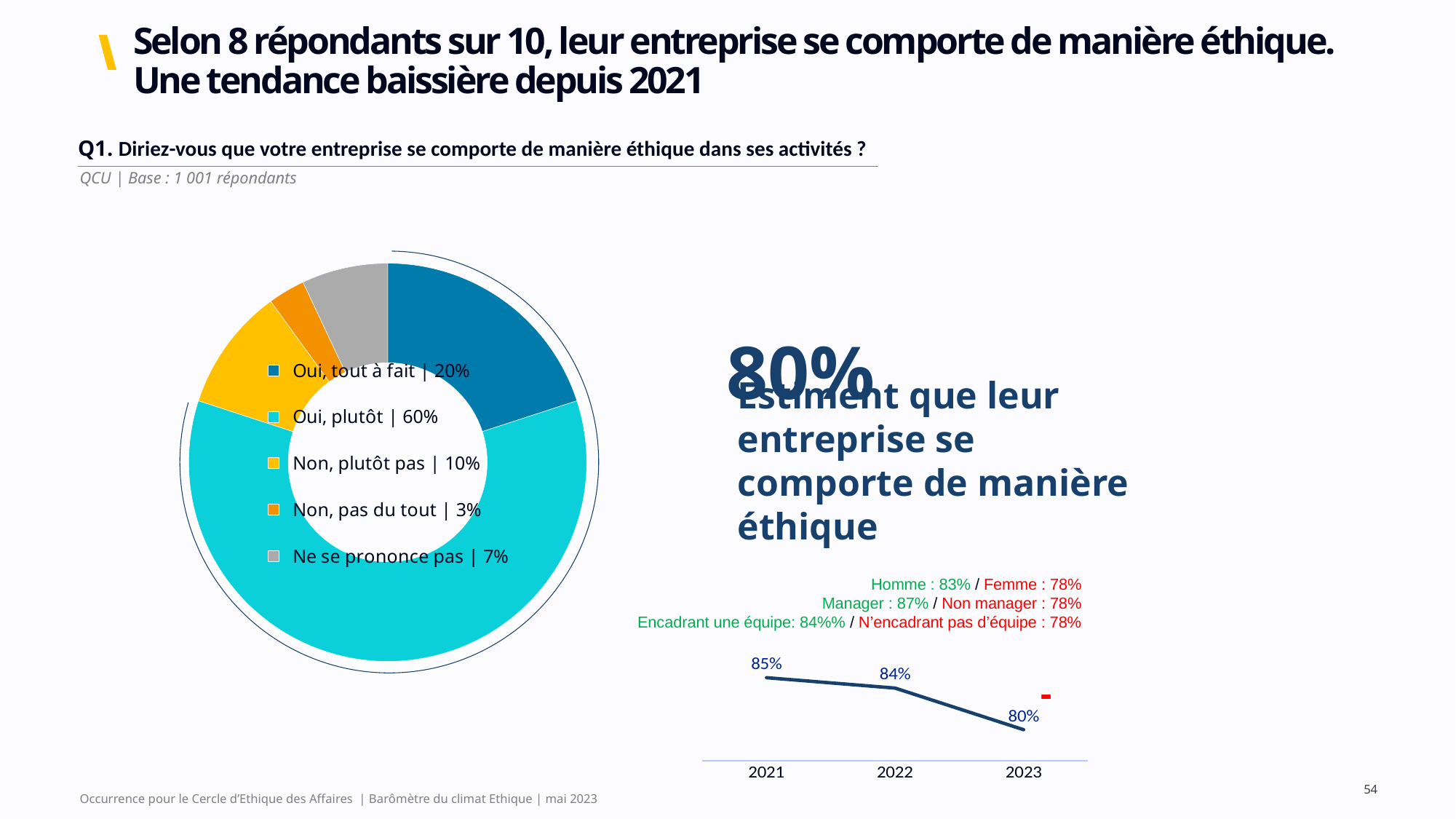
In the donut chart on the left, what share of respondents answered "Non, pas du tout"? 3% In the donut chart on the left, which is larger: "Ne se prononce pas" or "Non, pas du tout"? Ne se prononce pas In the donut chart on the left, which category has the smallest share? Non, pas du tout In the line chart at the bottom right, what is the difference between the 2021 and 2023 values? 5 percentage points In the donut chart on the left, which category has the largest share? Oui, plutôt In the donut chart on the left, what is the difference between "Oui, tout à fait" and "Non, plutôt pas"? 10 percentage points In the line chart at the bottom right, do the values rise or fall from 2021 to 2023? Fall In the donut chart on the left, what share of respondents answered "Oui, plutôt"? 60% In the line chart at the bottom right, what is the value for 2021? 85% How many categories does the donut chart on the left show? 5 What type of chart is shown on the left of the slide? Donut (pie) chart In the line chart at the bottom right, what is the value for 2022? 84%